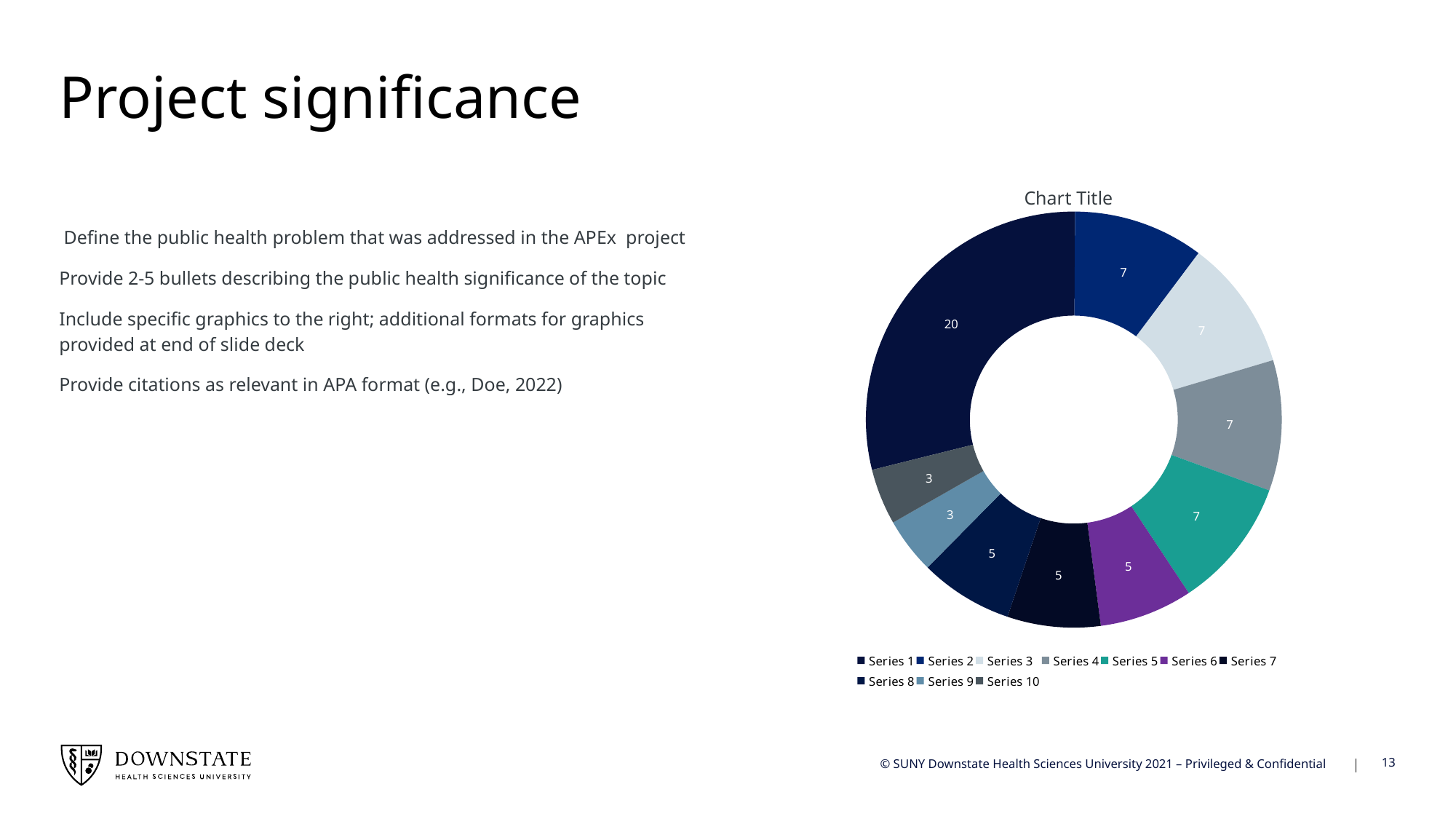
Which is larger, the value for Series 4 or the value for Series 7? Series 4 What is the difference between the values for Series 1 and Series 2? 13 What kind of chart is shown on the slide? Doughnut (pie) chart How many series does the legend list? 10 How many slices does the chart have? 10 What is the value for Series 5 in the chart? 7 What is the value for Series 6 in the chart? 5 What is the title of the chart? Chart Title Which series has the largest slice in the chart? Series 1 What is the value for Series 1 in the chart? 20 What is the value for Series 9 in the chart? 3 What is the smallest value shown on any slice of the chart? 3